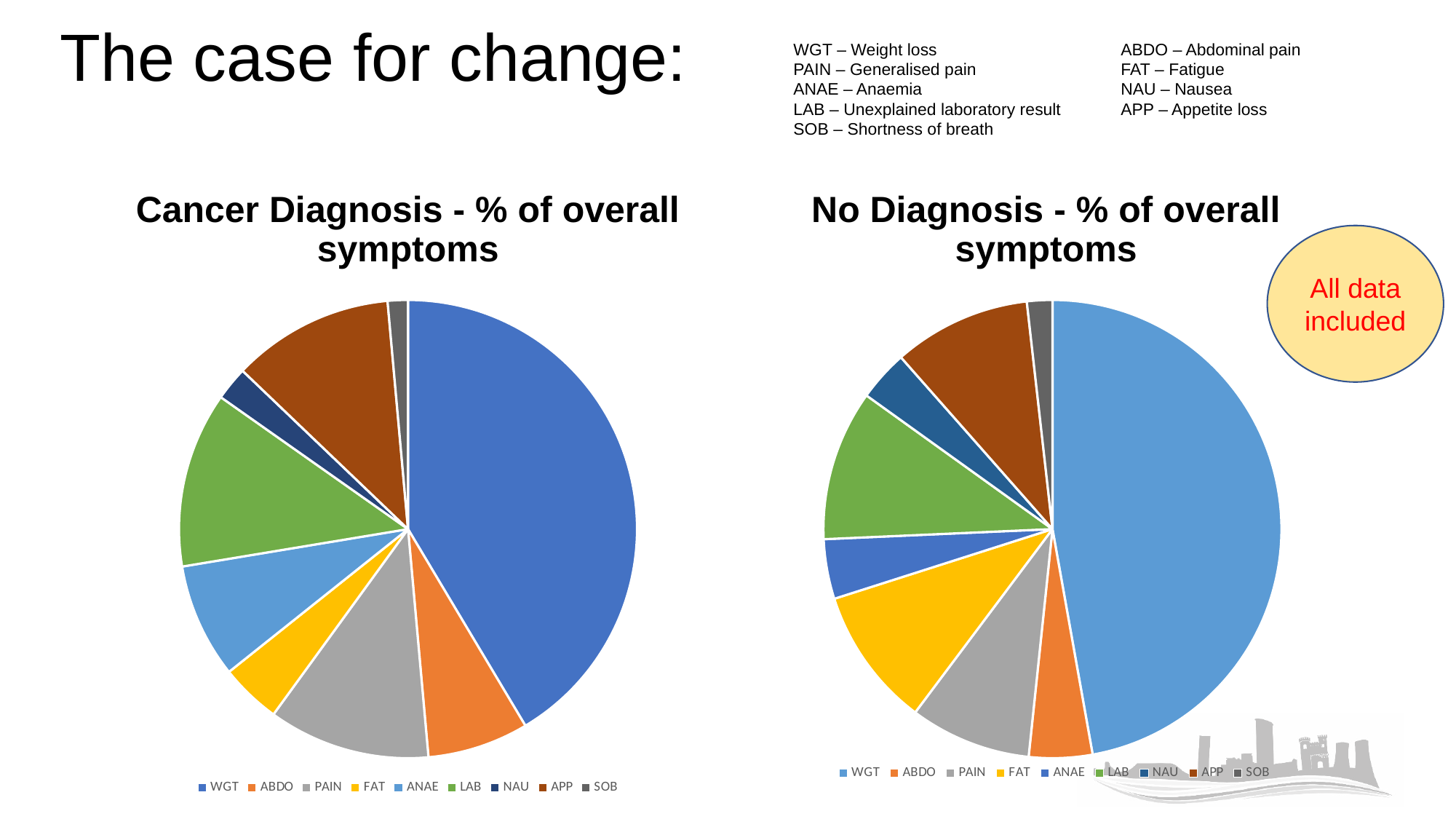
In the "Cancer Diagnosis - % of overall symptoms" chart, which symptom has the largest slice? WGT In the "No Diagnosis - % of overall symptoms" chart, which slice is larger, FAT or ABDO? FAT In the "Cancer Diagnosis - % of overall symptoms" chart, which slice is larger, PAIN or FAT? PAIN How many slices does the "No Diagnosis - % of overall symptoms" pie chart have? 9 What is the title of the pie chart on the right side of the slide? No Diagnosis - % of overall symptoms How many symptom categories does the legend of the "Cancer Diagnosis - % of overall symptoms" chart list? 9 What kind of chart is the "Cancer Diagnosis - % of overall symptoms" chart? Pie chart What kind of chart is the "No Diagnosis - % of overall symptoms" chart? Pie chart In the "Cancer Diagnosis - % of overall symptoms" chart, which symptom has the smallest slice? SOB In the "No Diagnosis - % of overall symptoms" chart, which symptom has the smallest slice? SOB In the "No Diagnosis - % of overall symptoms" chart, which symptom has the largest slice? WGT In the "Cancer Diagnosis - % of overall symptoms" chart, which slice is larger, LAB or SOB? LAB